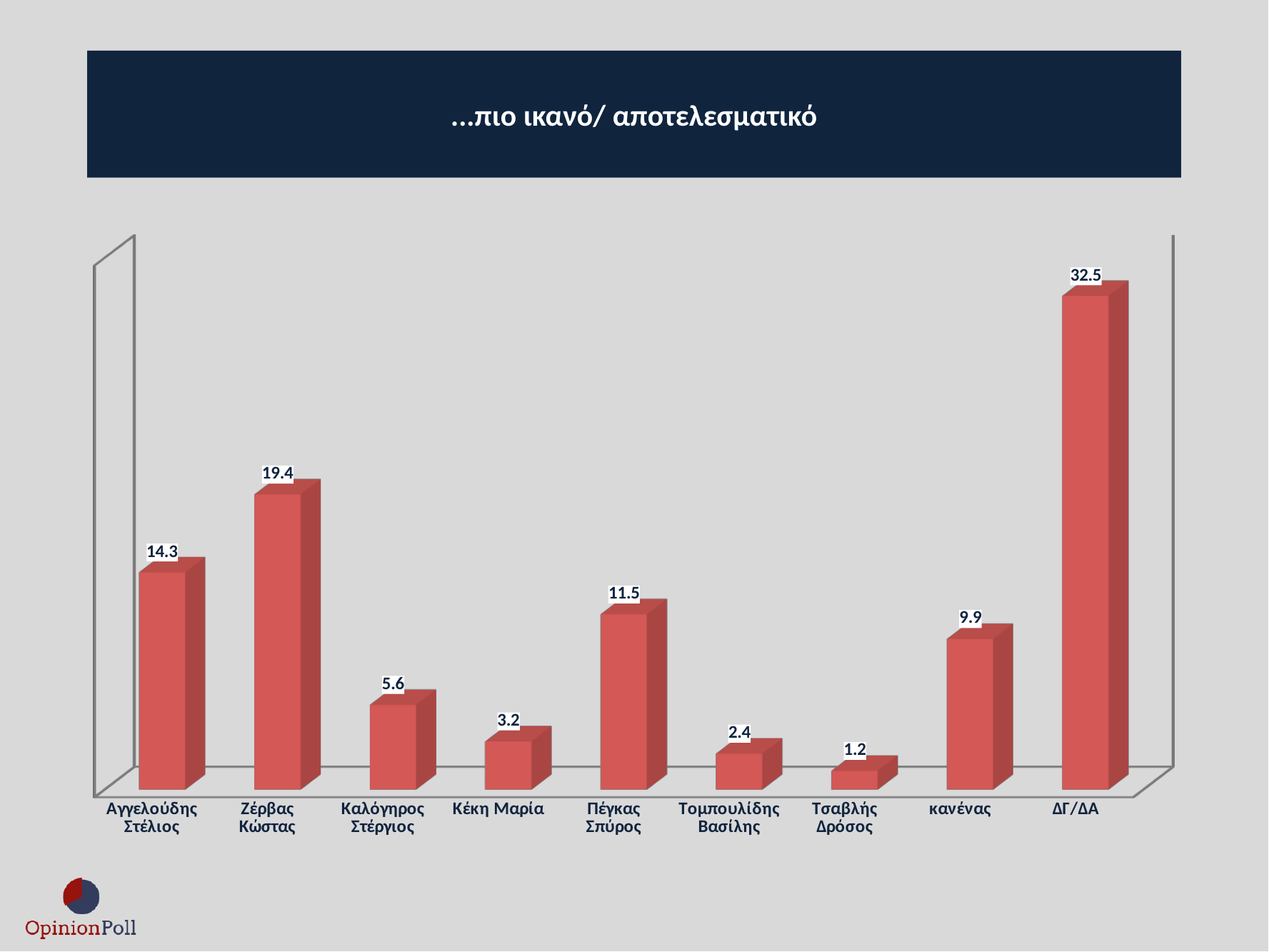
How many categories are shown on the x axis? 9 What is the difference between the values for Ζέρβας Κώστας and Αγγελούδης Στέλιος? 5.1 What is the value for Πέγκας Σπύρος? 11.5 What is the value for Ζέρβας Κώστας? 19.4 What is the value for Αγγελούδης Στέλιος? 14.3 Which is larger, the value for Πέγκας Σπύρος or the value for κανένας? Πέγκας Σπύρος What is the difference between the values for Καλόγηρος Στέργιος and Κέκη Μαρία? 2.4 What is the value for κανένας? 9.9 Which category has the highest value? ΔΓ/ΔΑ Which category has the lowest value? Τσαβλής Δρόσος What is the title of the chart? ...πιο ικανό/ αποτελεσματικό What kind of chart is shown on the slide? bar chart